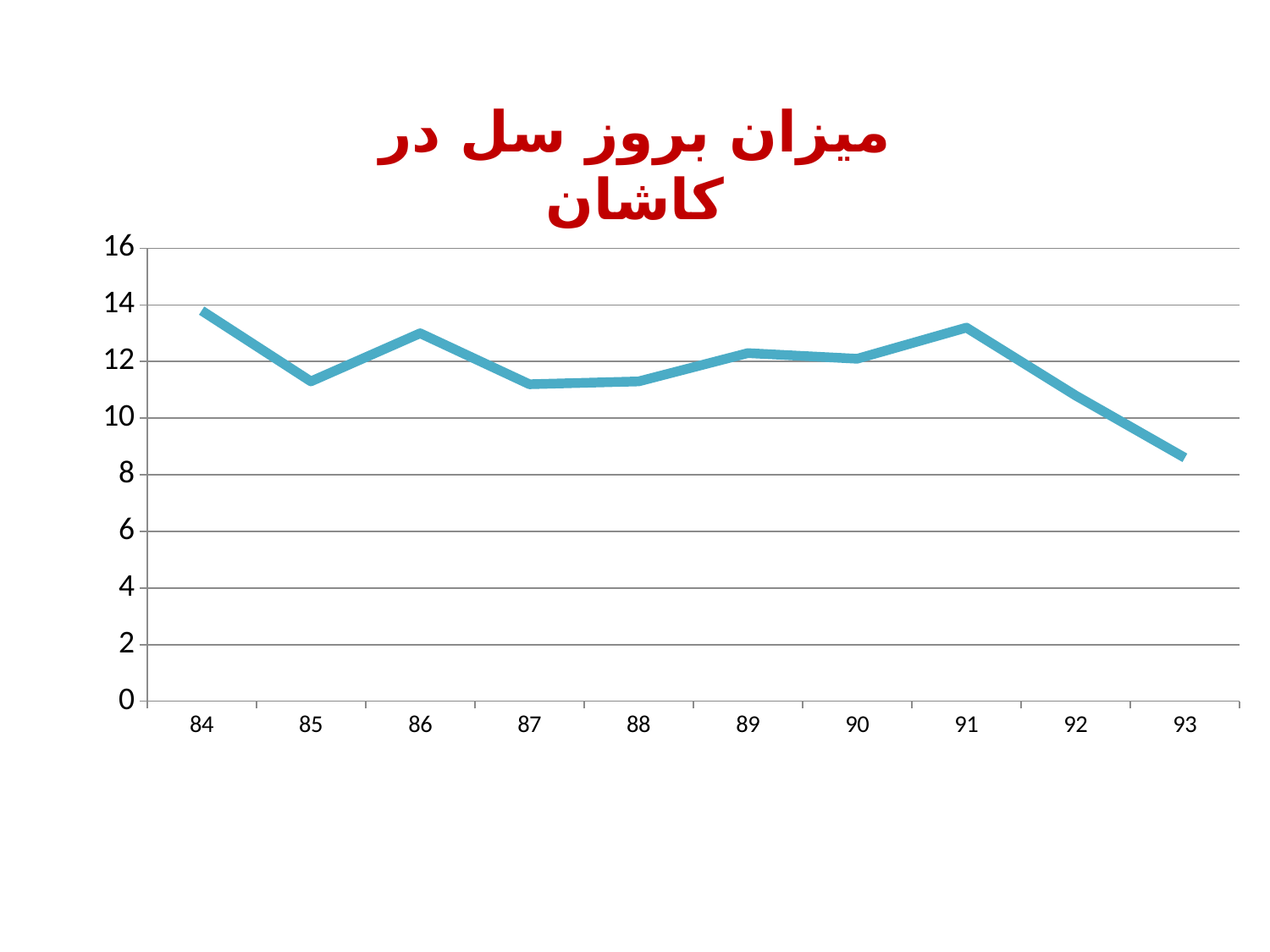
Is the value for 85 greater or less than 12? less How many years are shown on the x axis of the chart? 10 Which is larger, the value for 84 or the value for 93? 84 Which year has the highest value on the chart? 84 Is the value for 91 greater or less than 12? greater Is the value for 93 greater or less than 10? less Which year has the lowest value on the chart? 93 What kind of chart is shown on the slide? line chart Does the line rise or fall between 91 and 93? fall What is the title of the chart? میزان بروز سل در کاشان